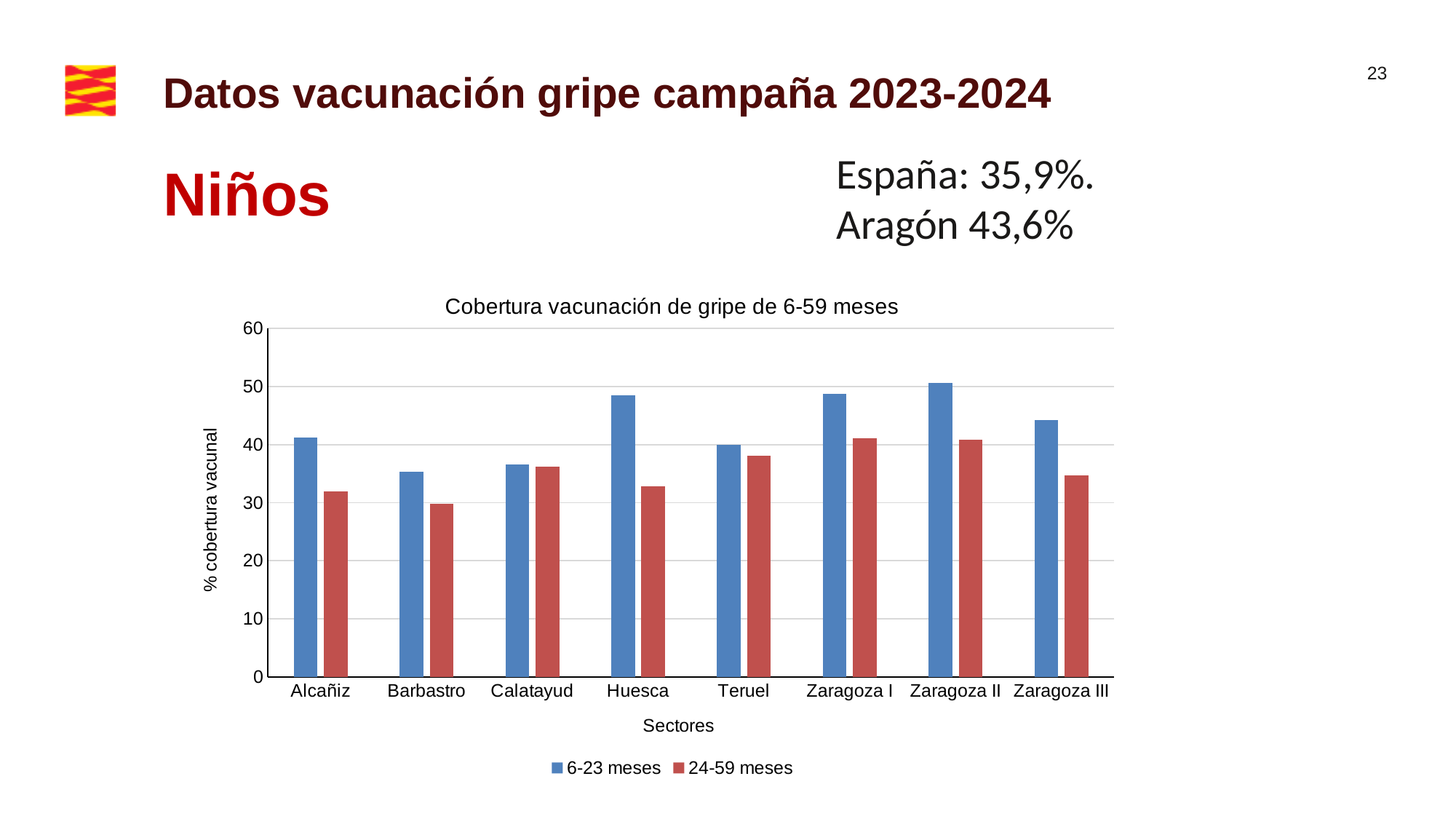
Is the 6-23 meses value for Alcañiz greater or less than 40? greater For Huesca, which series has the larger value: 6-23 meses or 24-59 meses? 6-23 meses Which sector has the highest value for the 6-23 meses series? Zaragoza II Is the 24-59 meses value for Teruel greater or less than 40? less What type of chart is shown on the slide? Bar chart Which is larger: the 6-23 meses value for Alcañiz or the 6-23 meses value for Barbastro? Alcañiz How many sectors are shown on the x axis of the chart? 8 Which sector has the lowest value for the 24-59 meses series? Barbastro How many series does the chart legend list? 2 What is the label of the y axis of the chart? % cobertura vacunal What is the title of the chart? Cobertura vacunación de gripe de 6-59 meses